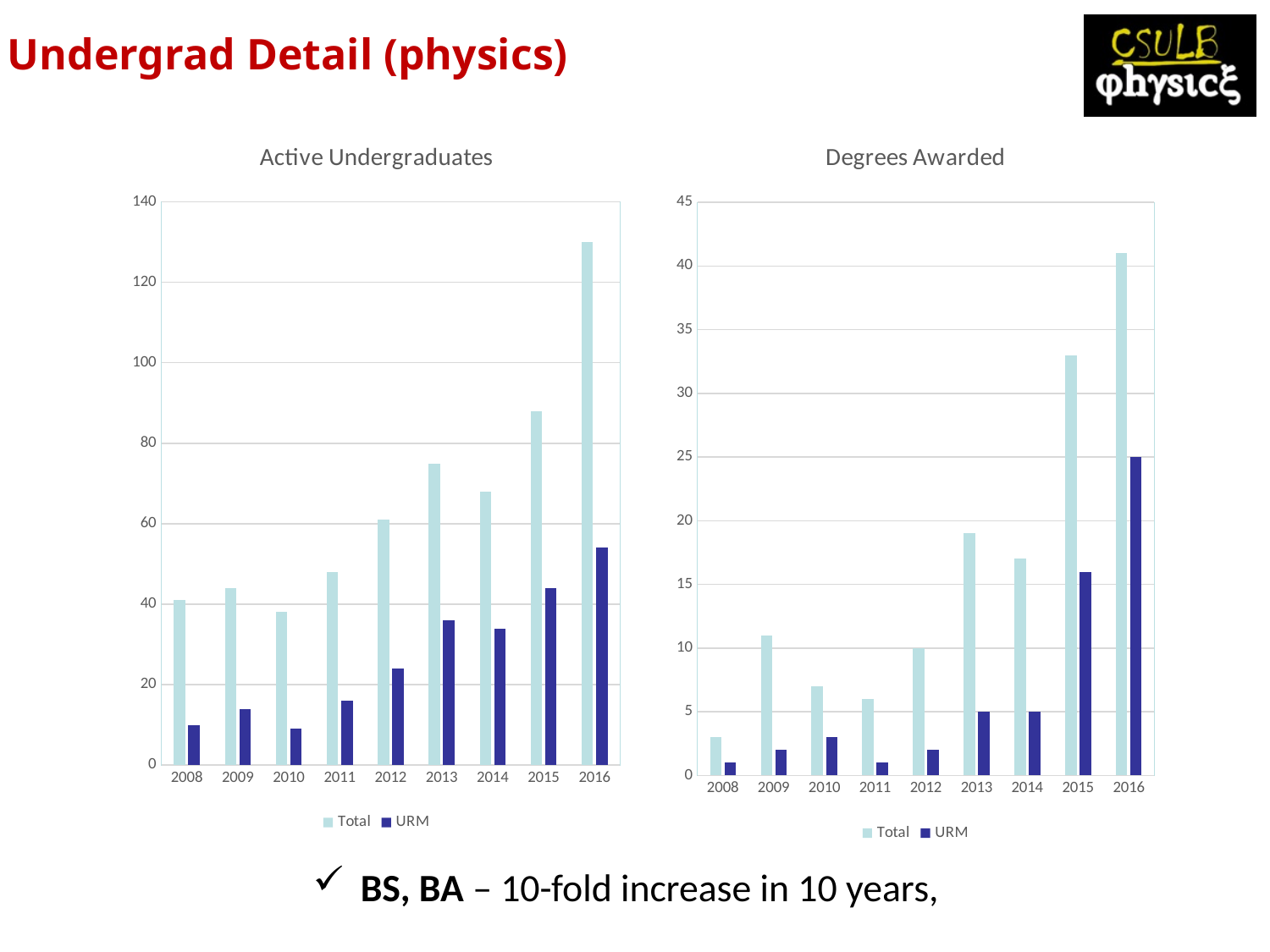
In the Active Undergraduates chart, which year has the lowest URM value? 2010 In the Degrees Awarded chart, which year has the highest Total value? 2016 How many years are shown on the x axis of the Active Undergraduates chart? 9 How many series does the legend of the Degrees Awarded chart list? 2 In the Active Undergraduates chart, is the Total value for 2016 greater or less than 120? greater In the Degrees Awarded chart, which is larger, the Total value for 2013 or the Total value for 2014? 2013 What is the title of the chart on the right side of the slide? Degrees Awarded In the Degrees Awarded chart, is the Total value for 2015 greater or less than 30? greater What type of chart is the Active Undergraduates chart? bar chart In the Active Undergraduates chart, is the URM value for 2013 greater or less than 40? less In the Degrees Awarded chart, which year has the lowest Total value? 2008 In the Active Undergraduates chart, which year has the highest Total value? 2016